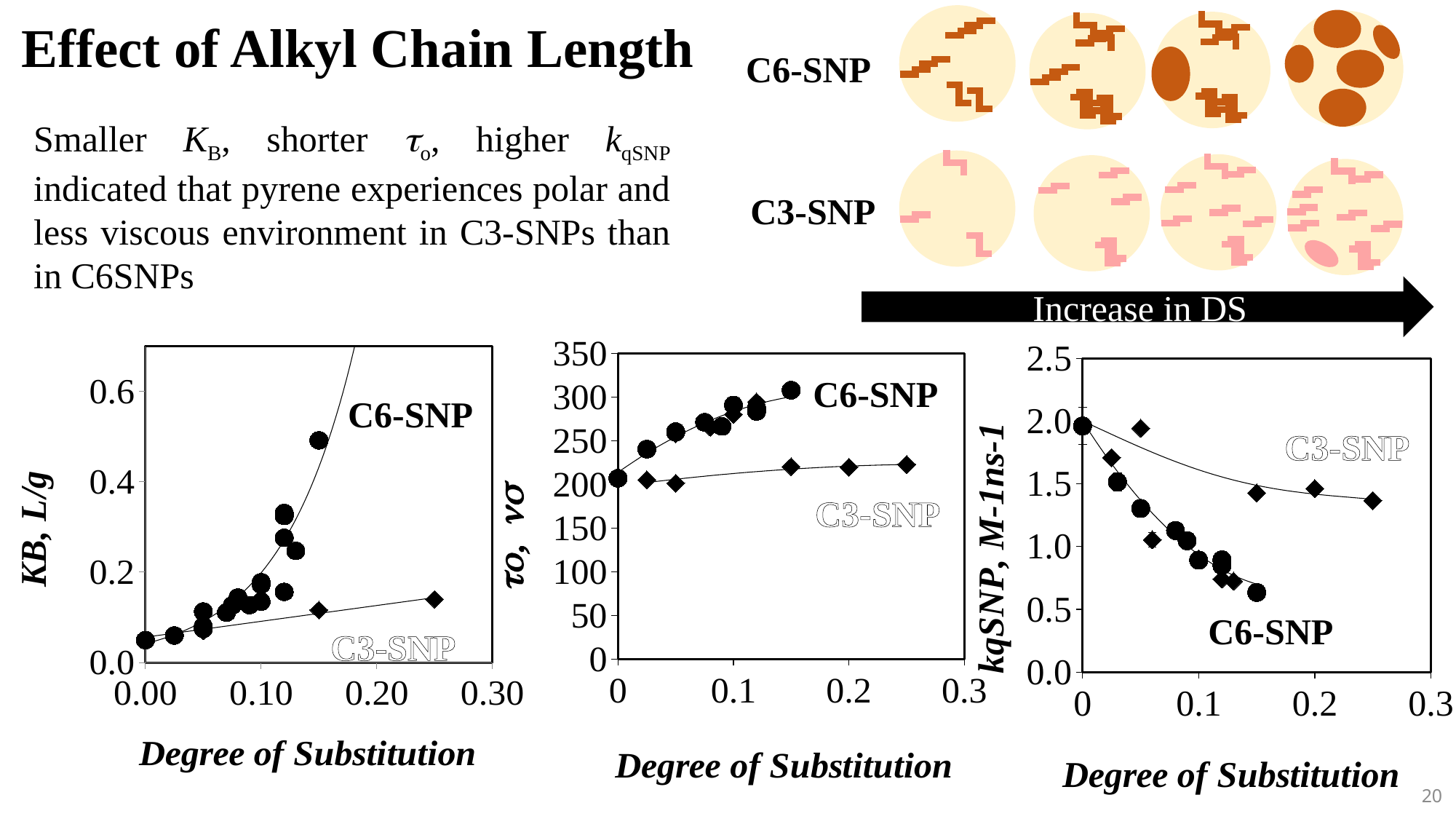
In the left chart (KB, L/g), is the C3-SNP value at Degree of Substitution 0.25 greater or less than 0.2? less In the right chart (kqSNP), is the C6-SNP value at Degree of Substitution 0.15 greater or less than 1.0? less In the middle chart (τo, ns), is the C3-SNP value at Degree of Substitution 0.25 greater or less than 250? less In the middle chart (τo, ns), how does the C6-SNP series change as Degree of Substitution increases? rises What is the x-axis label shared by all three charts? Degree of Substitution What kind of chart is the left chart (KB, L/g vs Degree of Substitution)? scatter chart In the left chart (KB, L/g), how does the C6-SNP series change as Degree of Substitution increases? rises In the right chart (kqSNP), how does the C6-SNP series change as Degree of Substitution increases? falls In the right chart (kqSNP), at Degree of Substitution 0.15, which series has the larger value, C6-SNP or C3-SNP? C3-SNP In the left chart (KB, L/g), at Degree of Substitution 0.15, which series has the larger value, C6-SNP or C3-SNP? C6-SNP